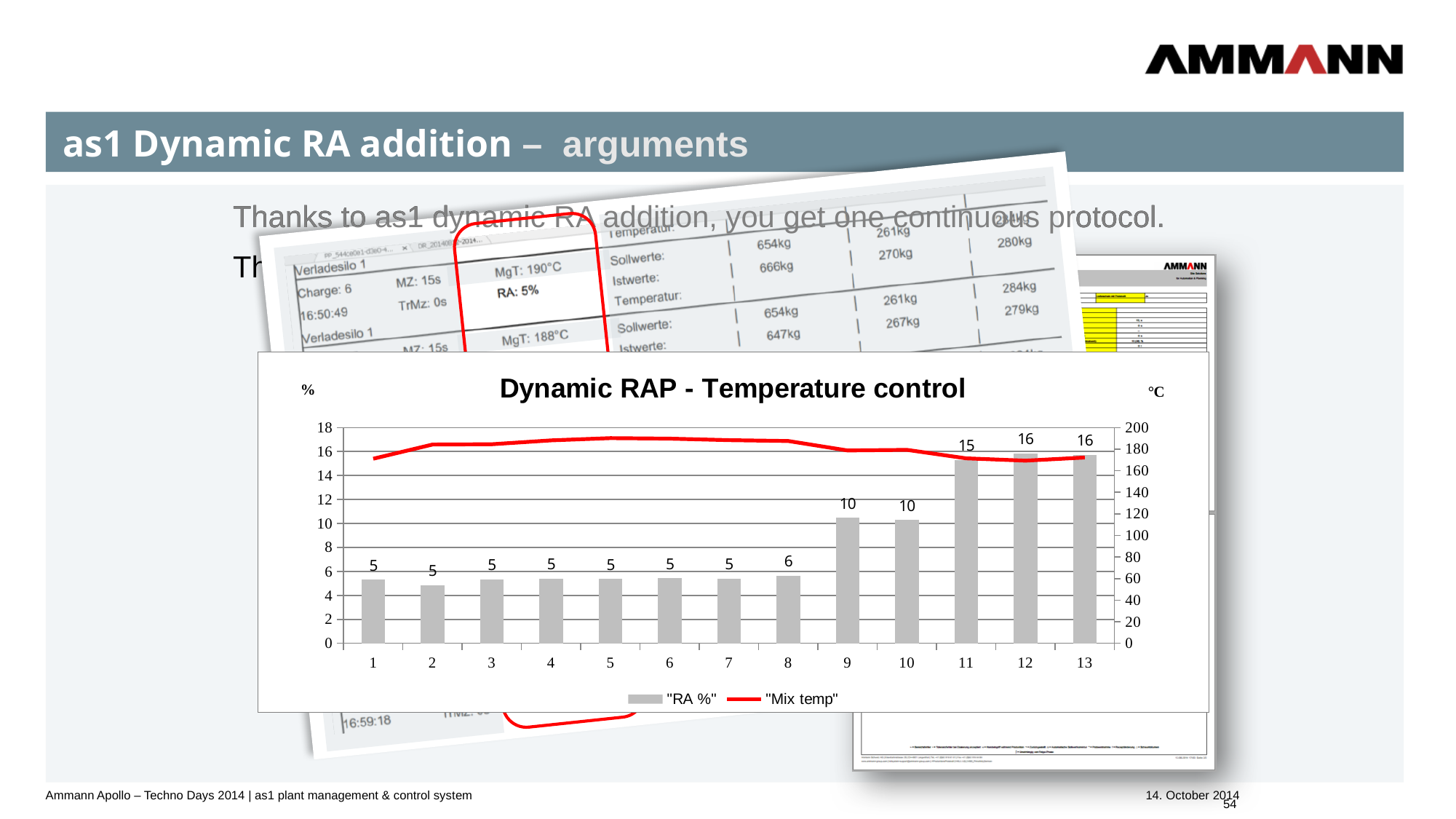
What is the RA % value for category 8? 6 Do the RA % values generally rise or fall from category 1 to category 13? rise How many series does the legend list? 2 What is the lowest RA % value shown on the chart? 5 What is the RA % value for category 9? 10 Is the Mix temp value for category 12 greater or less than 180? less What is the difference between the RA % values for category 13 and category 1? 11 Is the Mix temp value for category 5 greater or less than 180? greater What is the title of the chart? Dynamic RAP - Temperature control How many categories are shown on the x axis? 13 What is the RA % value for category 12? 16 Which has a larger RA % value, category 11 or category 8? Category 11